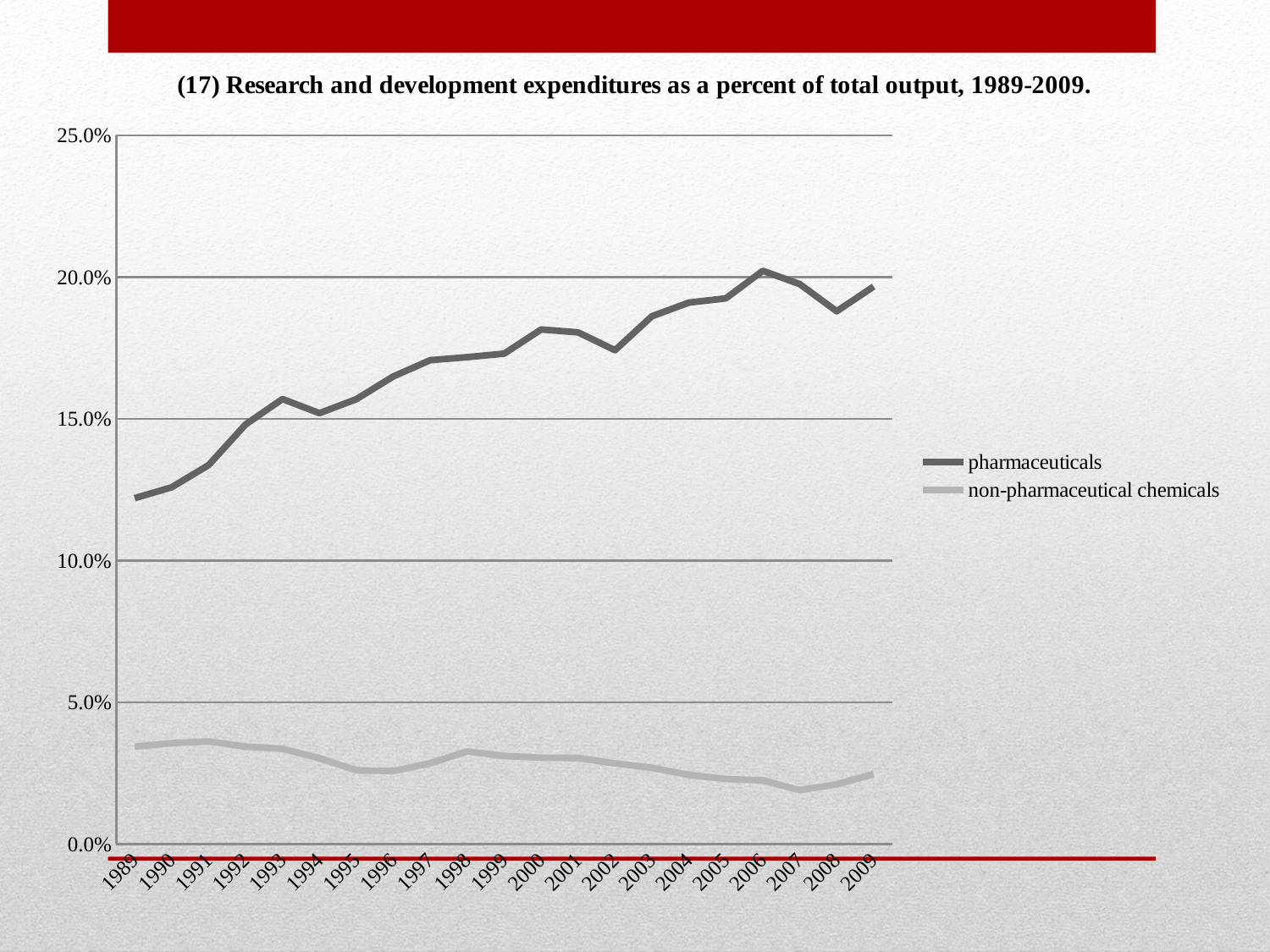
What is the title of the chart? (17) Research and development expenditures as a percent of total output, 1989-2009. In which year does the pharmaceuticals line have its lowest value? 1989 In which year does the pharmaceuticals line reach its highest value? 2006 What kind of chart is shown on the slide? line chart Which series has the higher value in 2000, pharmaceuticals or non-pharmaceutical chemicals? pharmaceuticals Is the value for pharmaceuticals in 1989 greater or less than 15.0%? less How many years are plotted along the x axis? 21 Does the non-pharmaceutical chemicals line generally rise or fall from 1989 to 2009? fall Does the pharmaceuticals line generally rise or fall from 1989 to 2009? rise Is the value for non-pharmaceutical chemicals in 2009 greater or less than 5.0%? less How many series does the legend list? 2